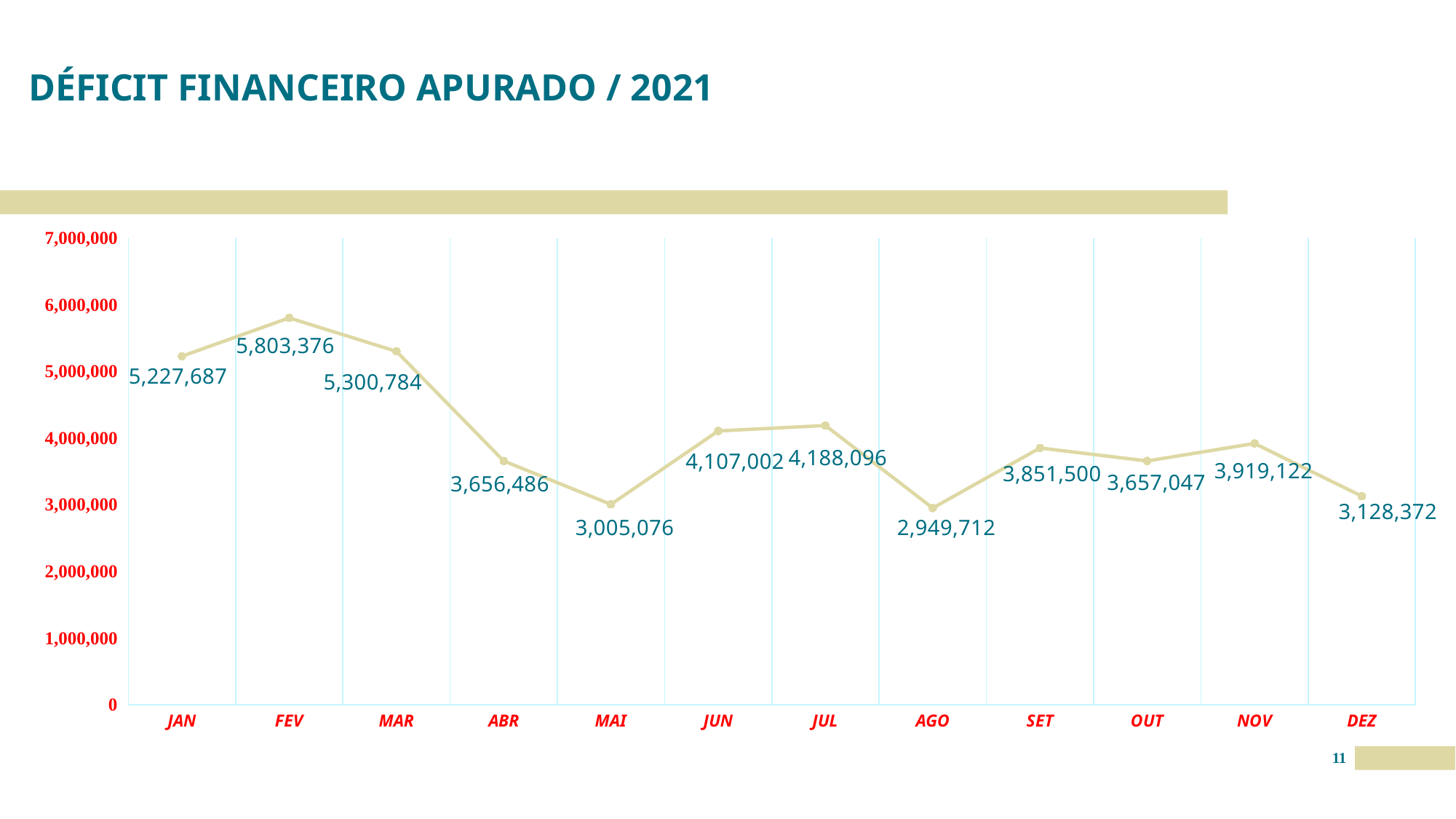
Which month has the lowest value? AGO Which is larger, the value for JUL or the value for JUN? JUL Is the value for MAR greater or less than 5,000,000? greater What type of chart is shown on the slide? line chart What is the value for OUT? 3,657,047 What is the value for FEV? 5,803,376 What is the value for AGO? 2,949,712 What is the difference between the values for NOV and DEZ? 790,750 What is the title of the slide? DÉFICIT FINANCEIRO APURADO / 2021 What is the difference between the values for FEV and JAN? 575,689 How many months are plotted on the chart? 12 Which month has the highest value? FEV